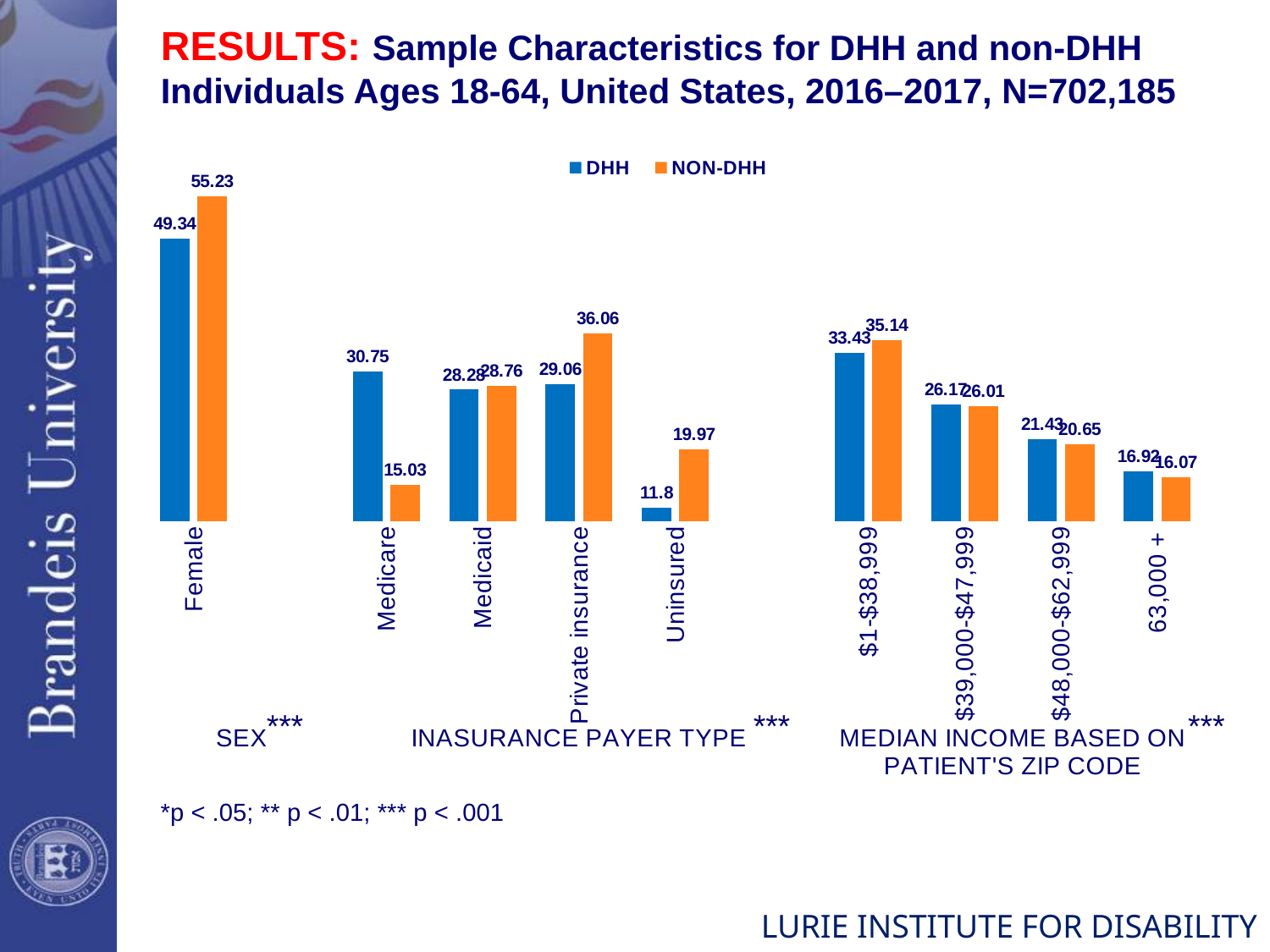
What is the NON-DHH value for Uninsured? 19.97 What kind of chart is shown on the slide? Bar chart Which category has the highest NON-DHH value? Female What is the NON-DHH value for Private insurance? 36.06 How many series does the legend list? 2 Which is larger for Uninsured, the DHH value or the NON-DHH value? NON-DHH What is the DHH value for the $1-$38,999 median income category? 33.43 What is the difference between the NON-DHH and DHH values for Medicare? 15.72 What is the DHH value for Female? 49.34 How many categories are shown on the x axis? 9 Which category has the lowest DHH value? Uninsured What is the DHH value for Medicare? 30.75